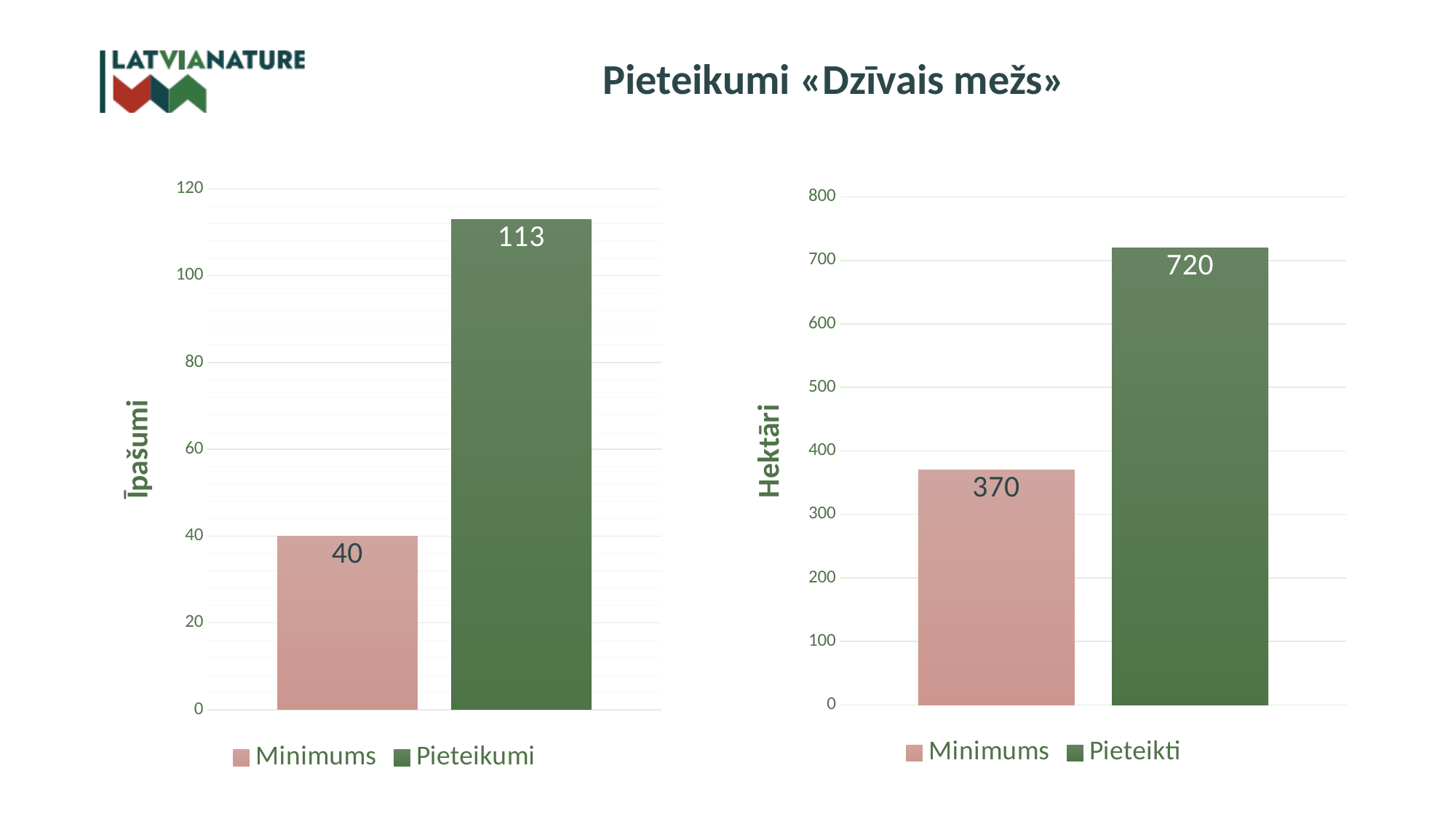
In the right chart (Hektāri), is the value for Minimums greater or less than 400? less In the right chart (Hektāri), what is the value for Minimums? 370 In the right chart (Hektāri), which is larger, Minimums or Pieteikti? Pieteikti How many series does the legend of the right chart (Hektāri) list? 2 In the right chart (Hektāri), what is the value for Pieteikti? 720 What is the title of the slide above the charts? Pieteikumi «Dzīvais mežs» In the left chart (Īpašumi), which series has the highest value? Pieteikumi In the left chart (Īpašumi), what is the difference between Pieteikumi and Minimums? 73 What kind of chart is the left chart (Īpašumi)? bar chart In the left chart (Īpašumi), what is the value for Pieteikumi? 113 In the right chart (Hektāri), what is the difference between Pieteikti and Minimums? 350 In the left chart (Īpašumi), what is the value for Minimums? 40